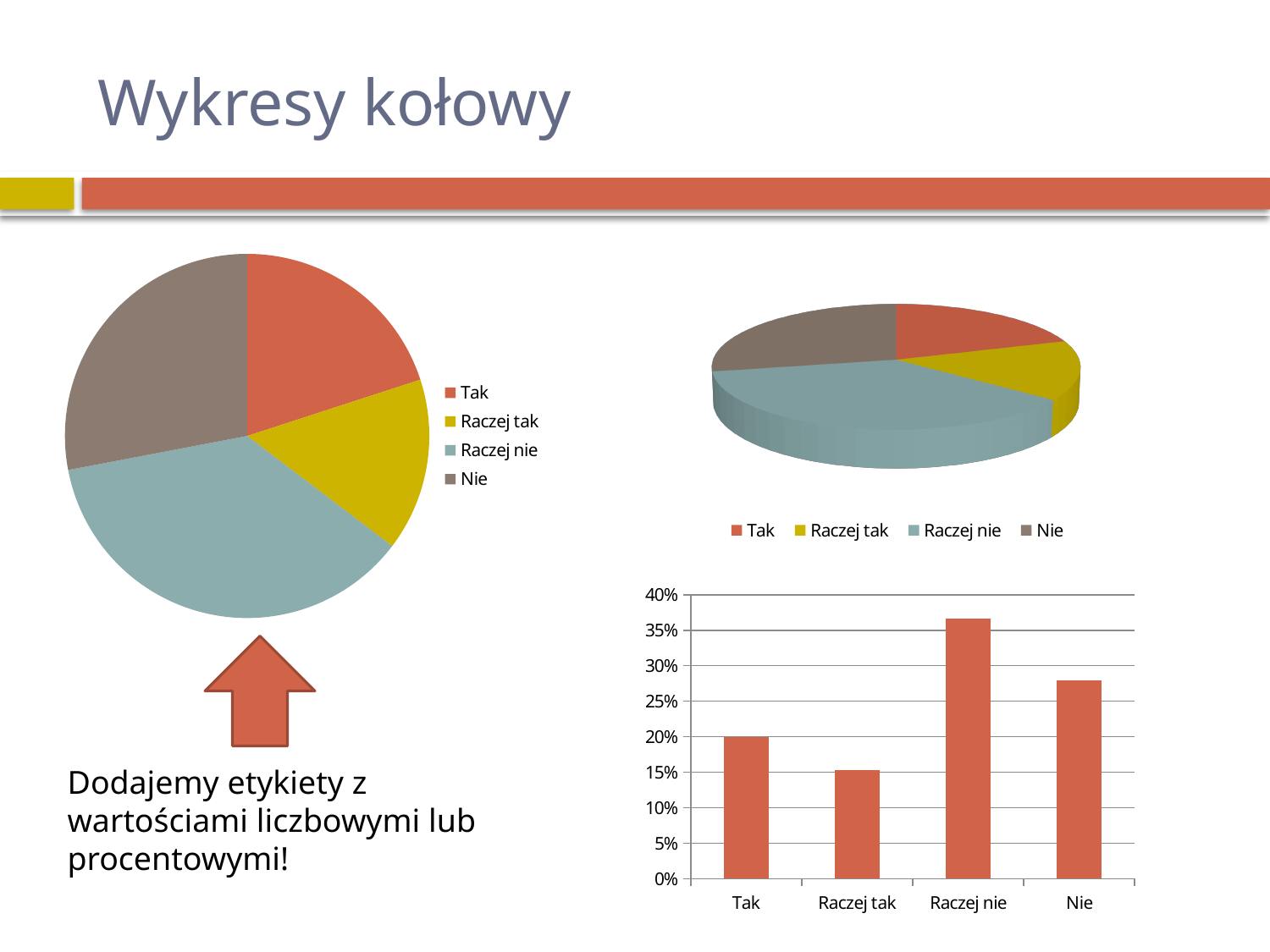
In the bar chart at the bottom right, is the value for Raczej nie greater or less than 35%? greater How many entries does the legend of the pie chart on the left list? 4 What kind of chart is the chart at the bottom right of the slide? bar chart In the bar chart at the bottom right, which is larger, the value for Tak or the value for Nie? Nie In the bar chart at the bottom right, is the value for Nie greater or less than 25%? greater What kind of chart is the chart on the left of the slide? pie chart How many categories are shown on the x axis of the bar chart at the bottom right? 4 In the bar chart at the bottom right, is the value for Raczej tak greater or less than 20%? less In the pie chart on the left, which slice is the largest? Raczej nie In the bar chart at the bottom right, which category has the lowest value? Raczej tak In the pie chart on the left, what colour is the Raczej tak slice? yellow In the bar chart at the bottom right, which category has the highest value? Raczej nie